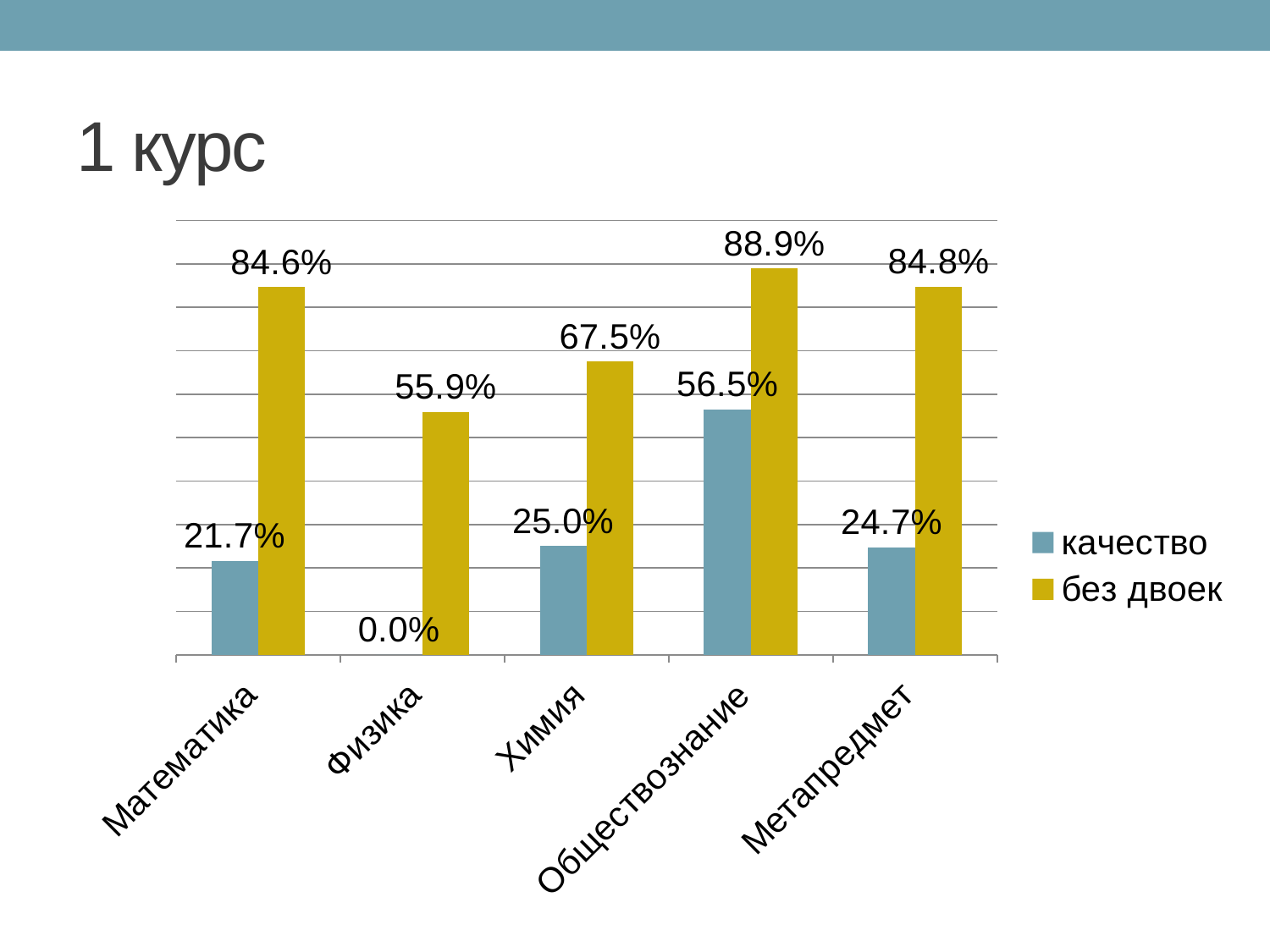
What type of chart is shown on the slide? Bar chart Which category has the lowest value for без двоек? Физика How many series does the legend list? 2 Which is larger: без двоек for Физика or без двоек for Химия? Химия What is the value of качество for Обществознание? 56.5% Which category has the lowest value for качество? Физика What is the value of без двоек for Математика? 84.6% How many categories are shown on the x axis? 5 What is the difference between без двоек and качество for Математика? 62.9 percentage points What is the value of без двоек for Химия? 67.5% What is the value of качество for Физика? 0.0% Which category has the highest value for без двоек? Обществознание